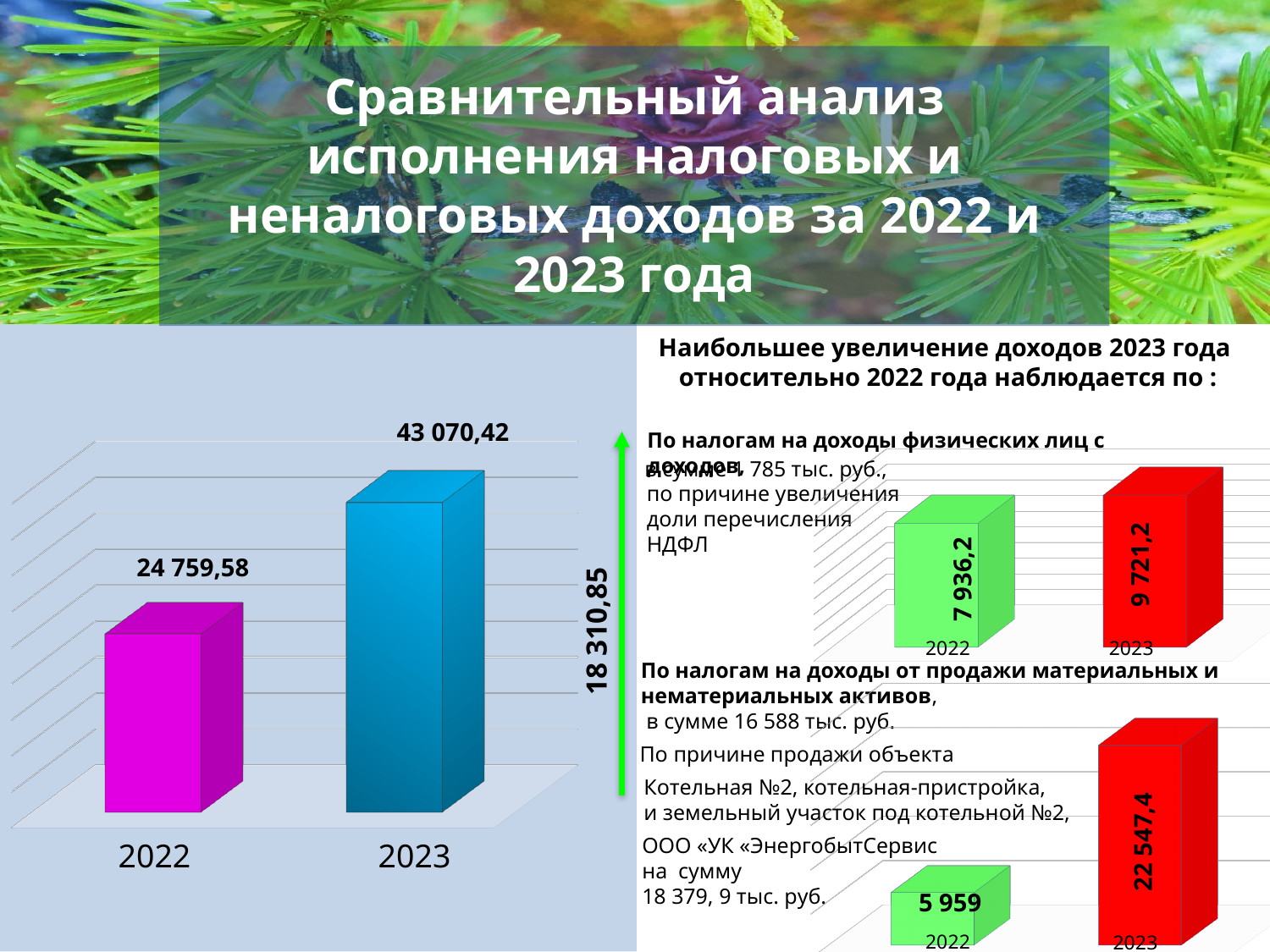
On the large chart on the left of the slide, what is the value for 2022? 24 759,58 On the bottom-right chart (income from sale of assets), which year has the lower value? 2022 On the bottom-right chart (income from sale of assets), what is the value for 2022? 5 959 On the top-right chart (taxes on personal income), what is the difference between the 2023 and 2022 values? 1 785 What kind of chart is the large chart on the left of the slide? bar chart What value is printed on the green arrow next to the large chart on the left of the slide? 18 310,85 On the large chart on the left of the slide, which year has the higher value? 2023 On the large chart on the left of the slide, how many bars are plotted? 2 On the large chart on the left of the slide, what is the value for 2023? 43 070,42 On the bottom-right chart (income from sale of assets), what is the value for 2023? 22 547,4 On the top-right chart (taxes on personal income), what is the value for 2022? 7 936,2 On the top-right chart (taxes on personal income), what is the value for 2023? 9 721,2